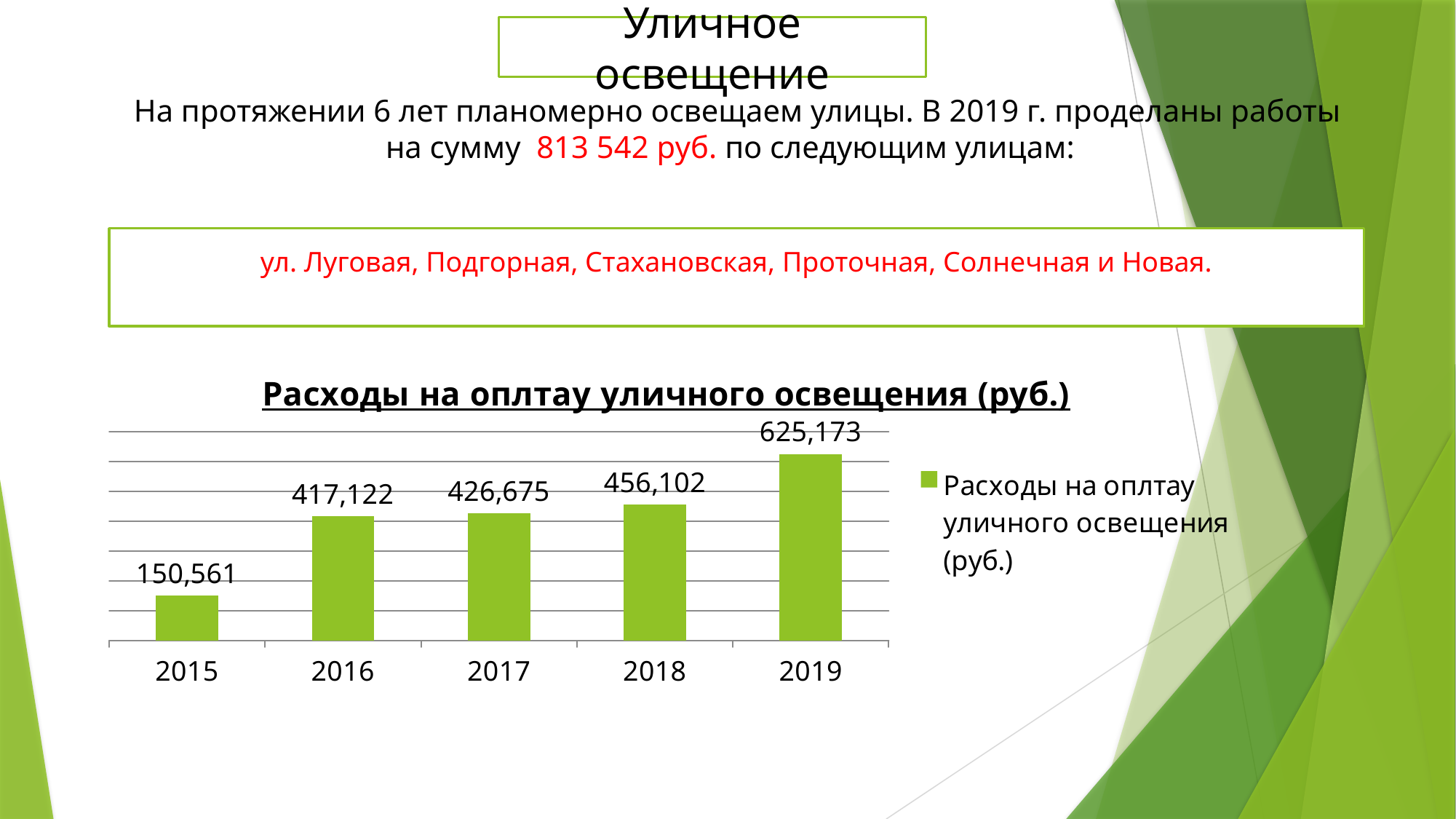
Do the values rise or fall from 2015 to 2019? rise Which year has the highest value in the chart? 2019 What kind of chart is shown on the slide? bar chart What is the value for 2019 in the chart? 625,173 What is the value for 2017 in the chart? 426,675 What is the difference between the values for 2019 and 2018? 169,071 What is the difference between the values for 2016 and 2015? 266,561 How many series does the legend list? 1 What is the value for 2015 in the chart? 150,561 Which is larger, the value for 2018 or the value for 2016? 2018 Which year has the lowest value in the chart? 2015 How many years are shown on the x axis of the chart? 5